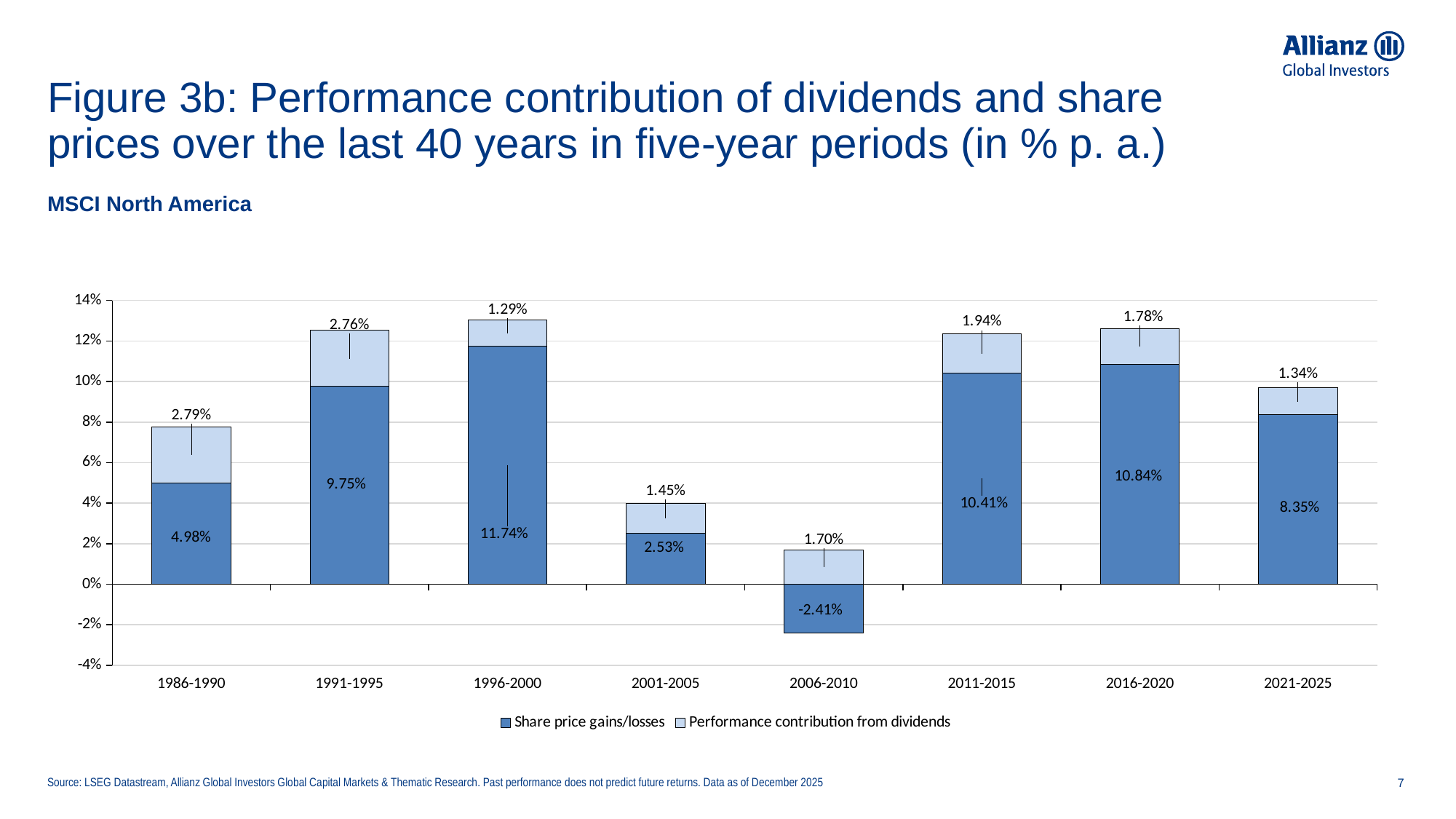
Which period has the lowest share price gains/losses? 2006-2010 How many series does the legend list? 2 What is the share price gains/losses value for 1996-2000? 11.74% Which period has the larger performance contribution from dividends, 2001-2005 or 2006-2010? 2006-2010 Which period has the highest share price gains/losses? 1996-2000 What is the performance contribution from dividends for 2011-2015? 1.94% How many five-year periods are shown on the x axis? 8 What is the share price gains/losses value for 2006-2010? -2.41% What is the difference between the share price gains/losses for 2016-2020 and 2011-2015? 0.43 percentage points What is the total of the stacked bar for 1991-1995? 12.51% Which period has the highest performance contribution from dividends? 1986-1990 What kind of chart is shown on the slide? Stacked bar chart